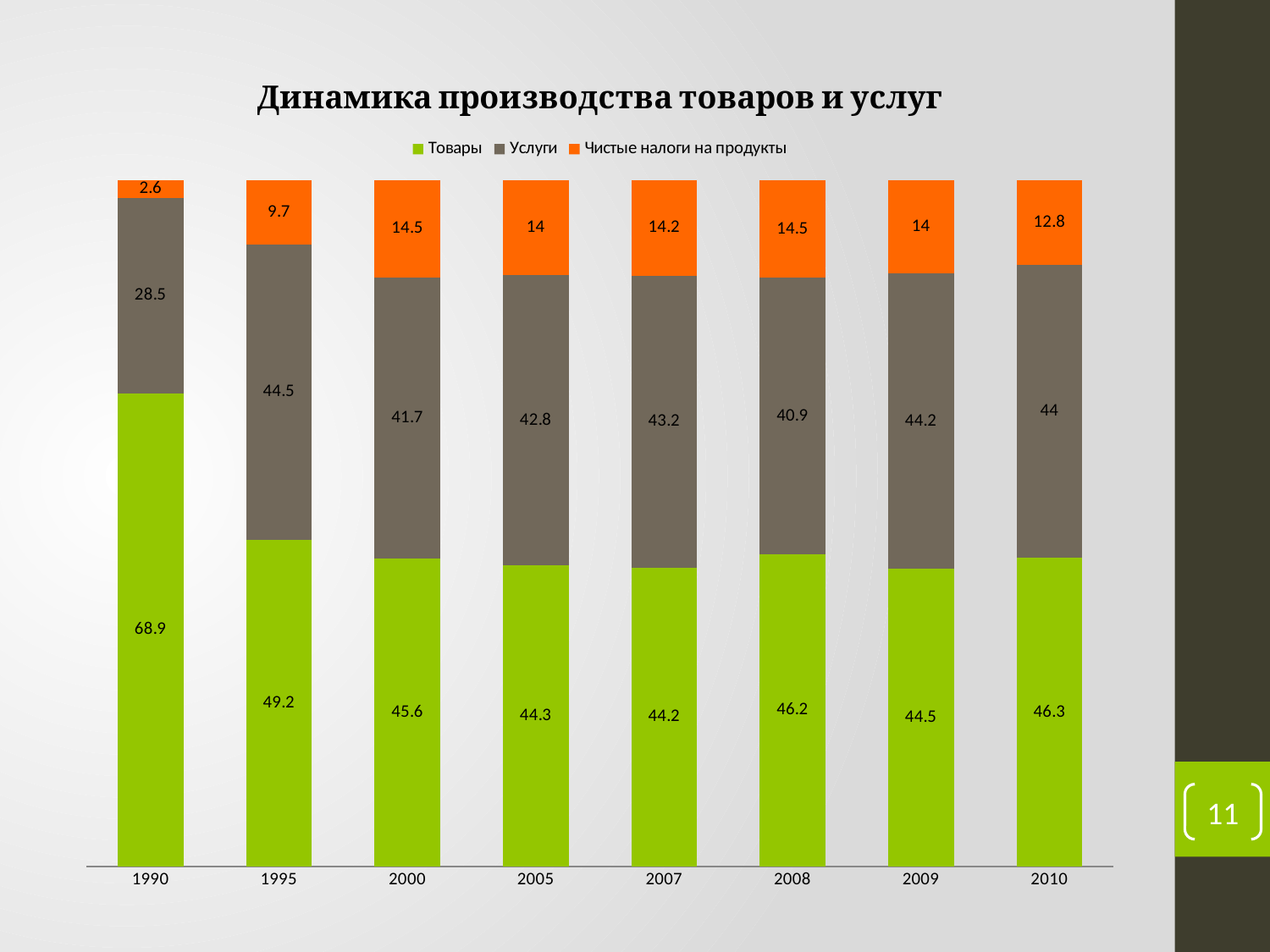
What is the value for Услуги in 2008? 40.9 Does the value for Товары rise or fall from 1990 to 2000? Fall What is the difference between the Товары values for 1990 and 2010? 22.6 What kind of chart is shown on the slide? Stacked bar chart How many years are shown on the x axis? 8 How many series does the legend list? 3 In which year is the value for Товары the highest? 1990 Which year has the larger value for Услуги, 2008 or 2009? 2009 What is the value for Товары in 1990? 68.9 In which year is the value for Чистые налоги на продукты the lowest? 1990 What is the value for Чистые налоги на продукты in 2010? 12.8 In which year is the value for Услуги the highest? 1995